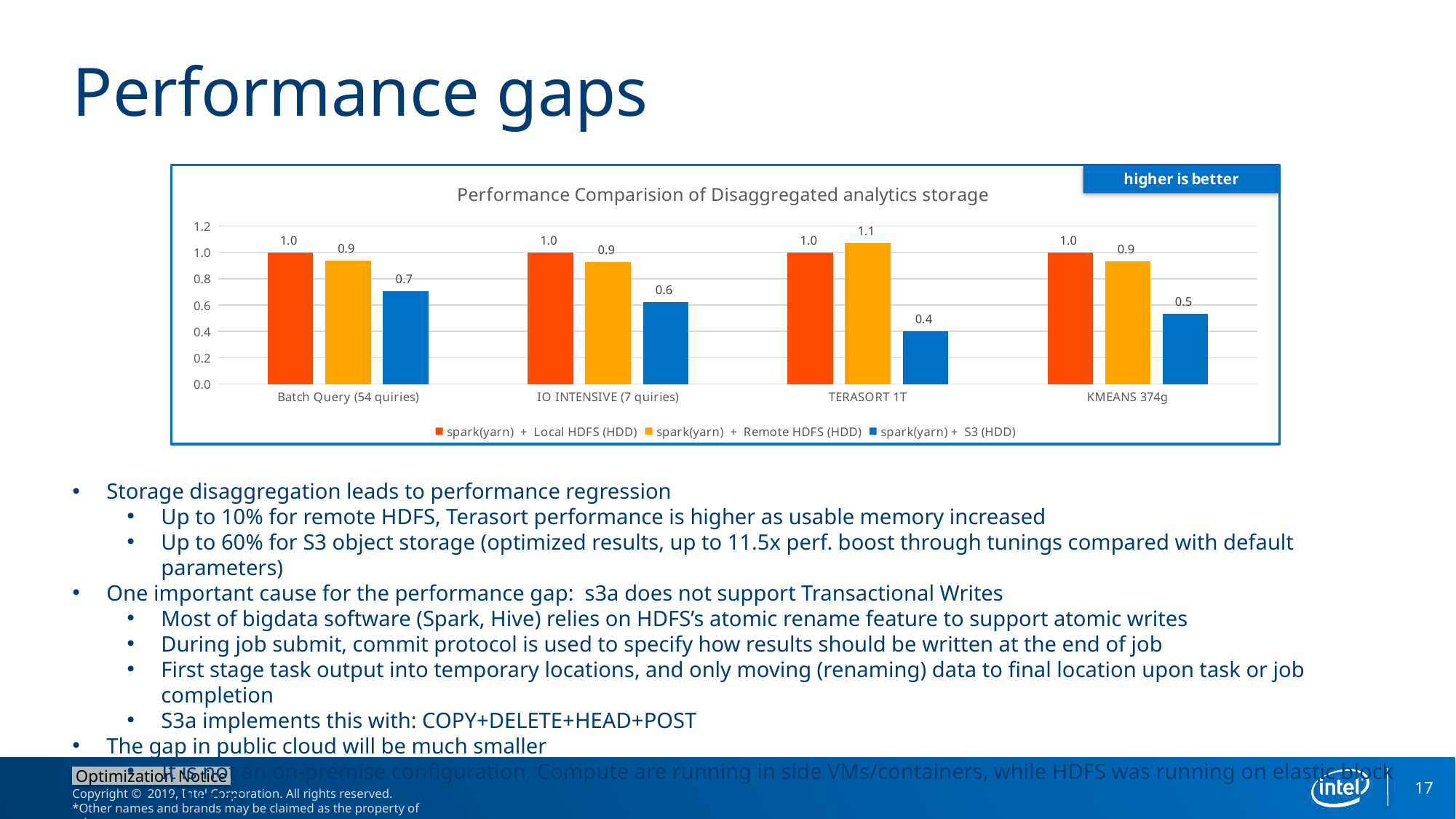
In which category does the spark(yarn) + S3 (HDD) series have its highest value? Batch Query (54 quiries) What is the value for spark(yarn) + Remote HDFS (HDD) in the TERASORT 1T category? 1.1 What is the value for spark(yarn) + S3 (HDD) in the KMEANS 374g category? 0.5 What is the value for spark(yarn) + S3 (HDD) in the Batch Query (54 quiries) category? 0.7 What kind of chart is shown on the slide? Bar chart How many series does the chart's legend list? 3 What is the title of the chart? Performance Comparision of Disaggregated analytics storage In the TERASORT 1T category, which is larger: spark(yarn) + Local HDFS (HDD) or spark(yarn) + Remote HDFS (HDD)? spark(yarn) + Remote HDFS (HDD) How many categories are shown on the x axis of the chart? 4 What is the value for spark(yarn) + S3 (HDD) in the TERASORT 1T category? 0.4 In which category does the spark(yarn) + S3 (HDD) series have its lowest value? TERASORT 1T What is the difference between the spark(yarn) + Local HDFS (HDD) value and the spark(yarn) + S3 (HDD) value in the IO INTENSIVE (7 quiries) category? 0.4